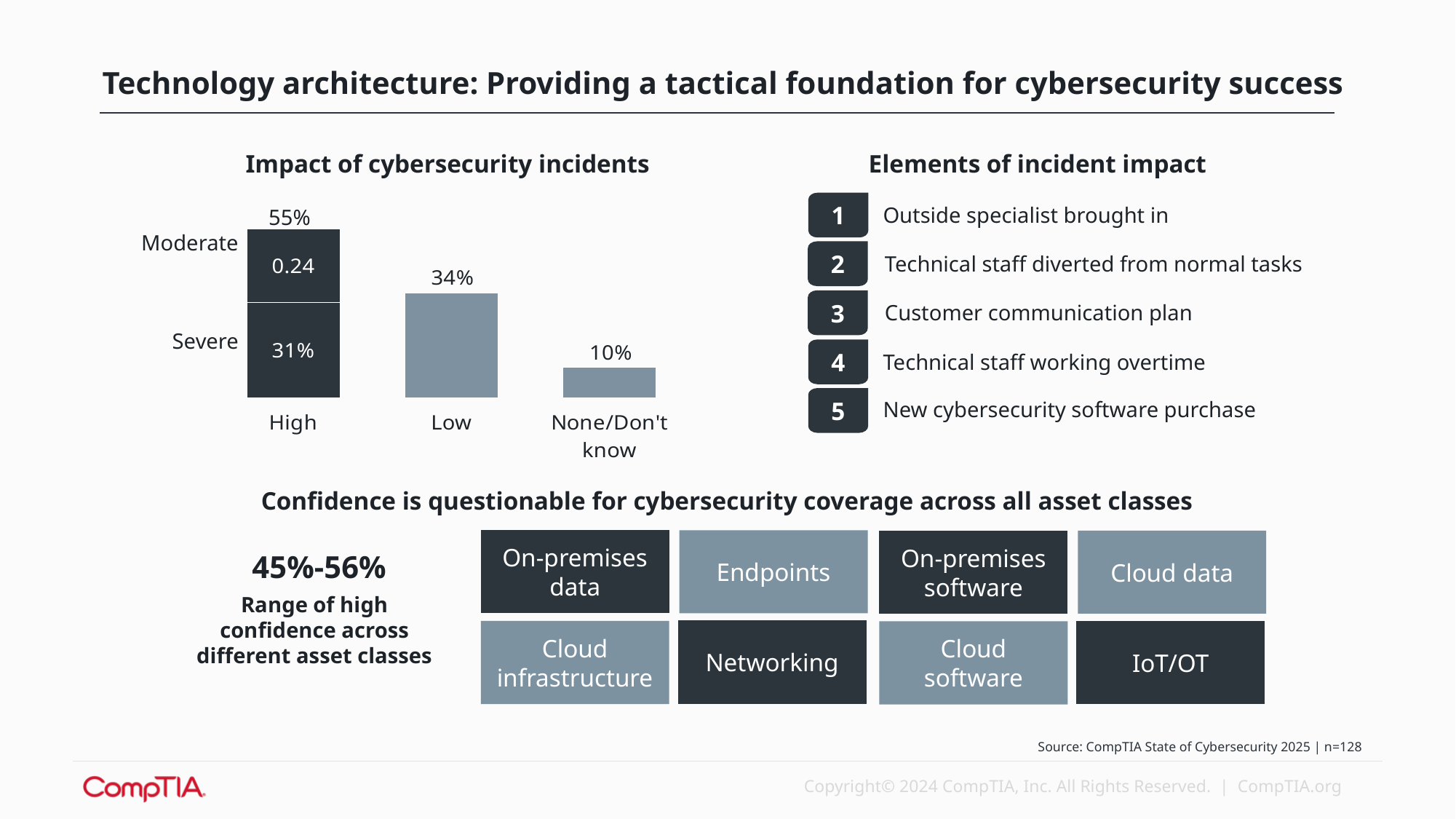
In the Impact of cybersecurity incidents chart, what is the total printed above the stacked High bar? 55% In the Impact of cybersecurity incidents chart, which is larger, Low or None/Don't know? Low In the Impact of cybersecurity incidents chart, what value is printed on the Moderate segment of the High bar? 0.24 In the Impact of cybersecurity incidents chart, what value is printed on the Severe segment of the High bar? 31% In the Impact of cybersecurity incidents chart, what is the value for Low? 34% In the Impact of cybersecurity incidents chart, which category has the lowest value? None/Don't know How many categories are shown on the x axis of the Impact of cybersecurity incidents chart? 3 In the Impact of cybersecurity incidents chart, which category has the highest overall value? High In the Impact of cybersecurity incidents chart, what is the difference between the High bar total and the Low value? 21% In the Impact of cybersecurity incidents chart, what is the value for None/Don't know? 10% What kind of chart is the Impact of cybersecurity incidents chart? Bar chart In the Impact of cybersecurity incidents chart, what is the difference between the Low value and the None/Don't know value? 24%